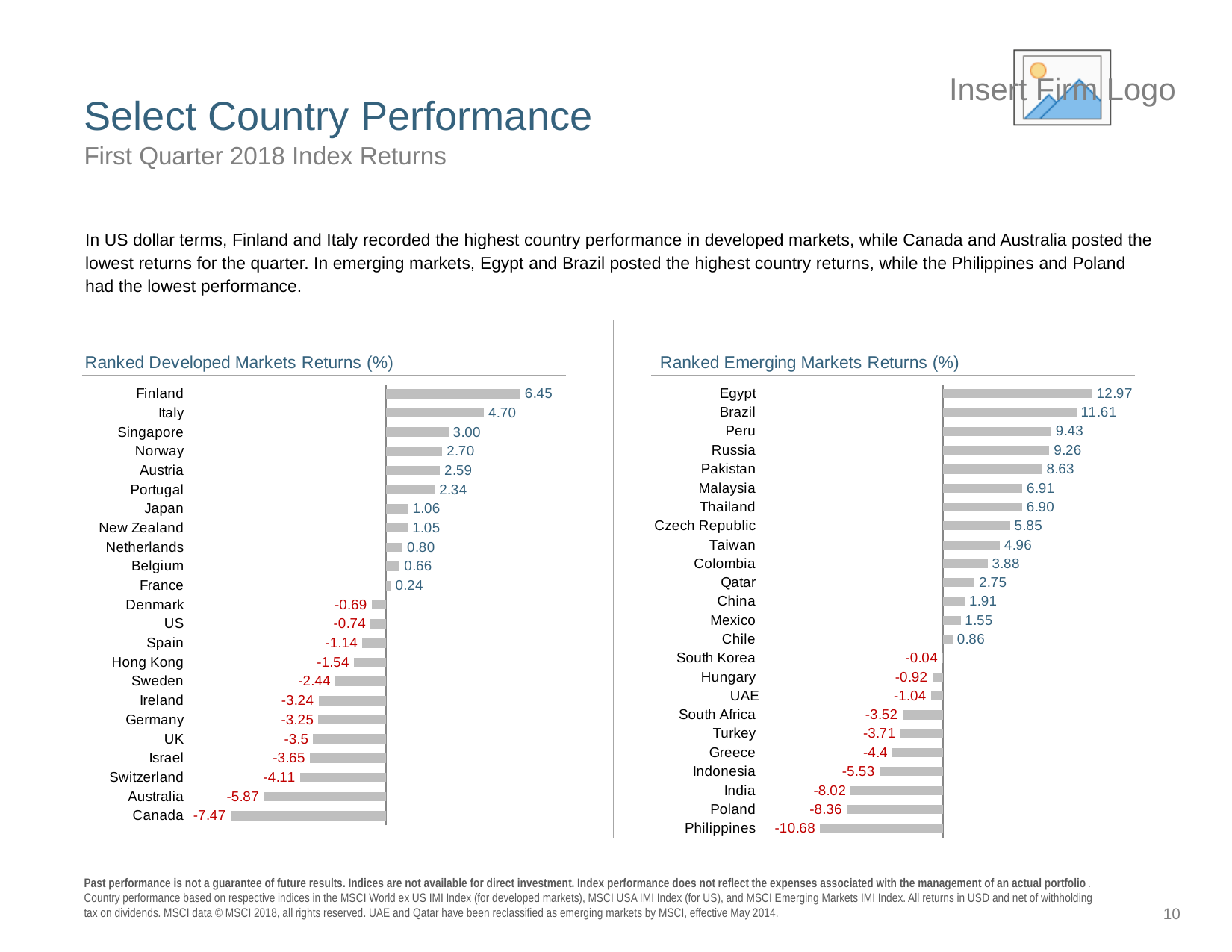
How many countries are shown in the Ranked Emerging Markets Returns (%) chart? 24 How many countries are shown in the Ranked Developed Markets Returns (%) chart? 23 In the Ranked Developed Markets Returns (%) chart, which country has the lowest return? Canada What type of chart is the Ranked Emerging Markets Returns (%) chart? Bar chart In the Ranked Emerging Markets Returns (%) chart, what is the difference between Egypt and Brazil? 1.36 In the Ranked Emerging Markets Returns (%) chart, what is the value for Egypt? 12.97 In the Ranked Developed Markets Returns (%) chart, which is larger, the value for Singapore or the value for Norway? Singapore In the Ranked Developed Markets Returns (%) chart, what is the value for Finland? 6.45 In the Ranked Emerging Markets Returns (%) chart, which country has the highest return? Egypt In the Ranked Developed Markets Returns (%) chart, what is the difference between Finland and Italy? 1.75 In the Ranked Emerging Markets Returns (%) chart, what is the value for Philippines? -10.68 In the Ranked Developed Markets Returns (%) chart, what is the value for Canada? -7.47